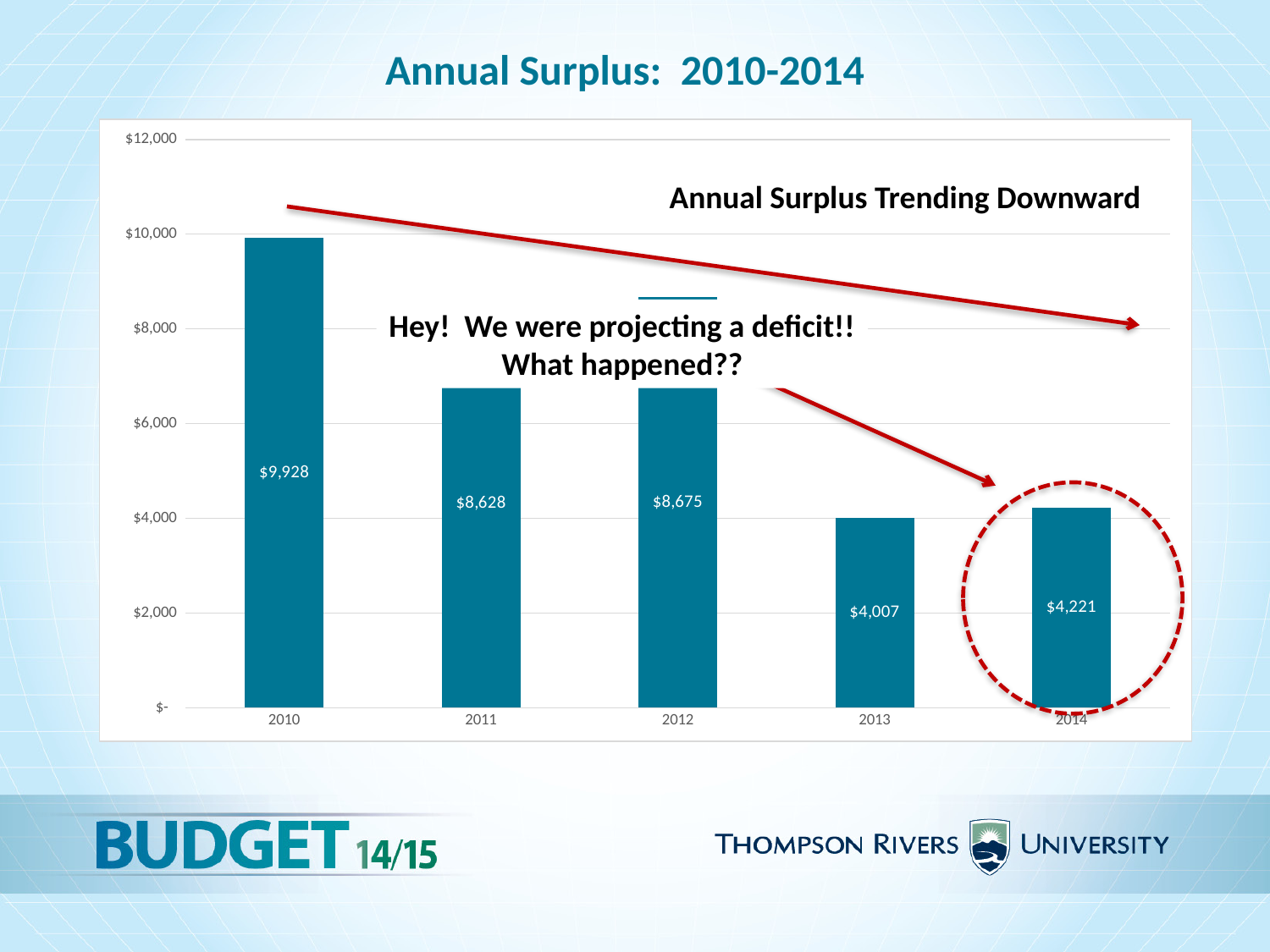
Which year has the highest annual surplus? 2010 Overall, does the annual surplus rise or fall from 2010 to 2014? Fall What is the annual surplus shown for 2011? $8,628 How many years are shown on the chart? 5 What is the difference between the 2014 surplus and the 2013 surplus? $214 What is the difference between the 2010 surplus and the 2013 surplus? $5,921 What is the annual surplus shown for 2010? $9,928 What kind of chart is shown on the slide? Bar chart Which year has the larger surplus, 2010 or 2014? 2010 What is the annual surplus shown for 2013? $4,007 What is the annual surplus shown for 2014? $4,221 Which year has the lowest annual surplus? 2013